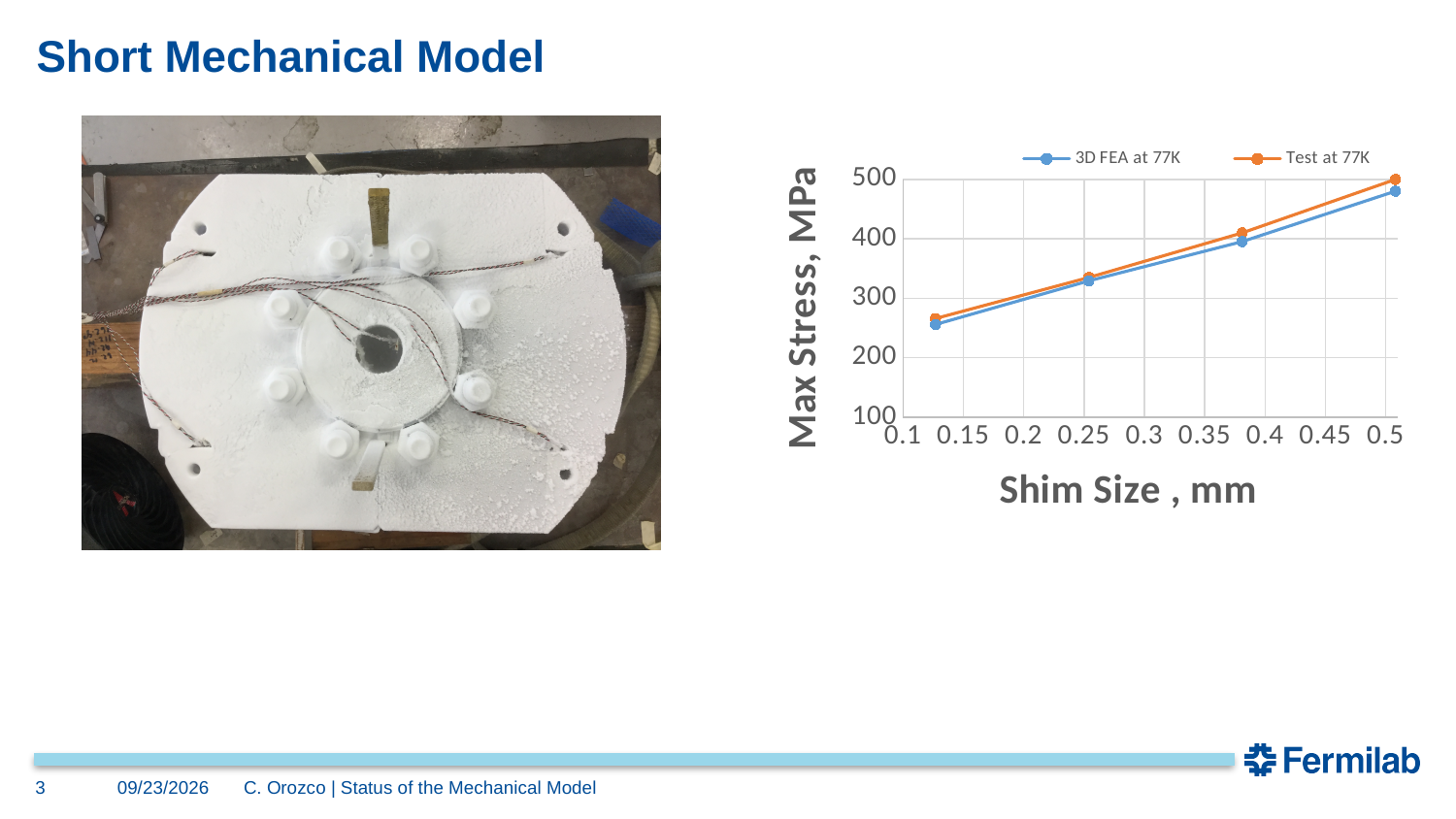
Is the value for 3D FEA at 77K at a shim size of 0.5 mm greater or less than 400? greater Does the max stress rise or fall as shim size increases along the x axis? rise What is the title of the chart's y axis? Max Stress, MPa At a shim size of 0.5 mm, which series has the higher max stress, 3D FEA at 77K or Test at 77K? Test at 77K At which shim size does the Test at 77K series reach its highest max stress? 0.5 mm What kind of chart is shown on the slide? line chart Is the value for Test at 77K at the smallest shim size plotted greater or less than 300? less Is the value for 3D FEA at 77K at a shim size of 0.25 mm greater or less than 300? greater What are the two series named in the chart legend? 3D FEA at 77K and Test at 77K How many series does the chart's legend list? 2 How many data points are plotted for the 3D FEA at 77K series? 4